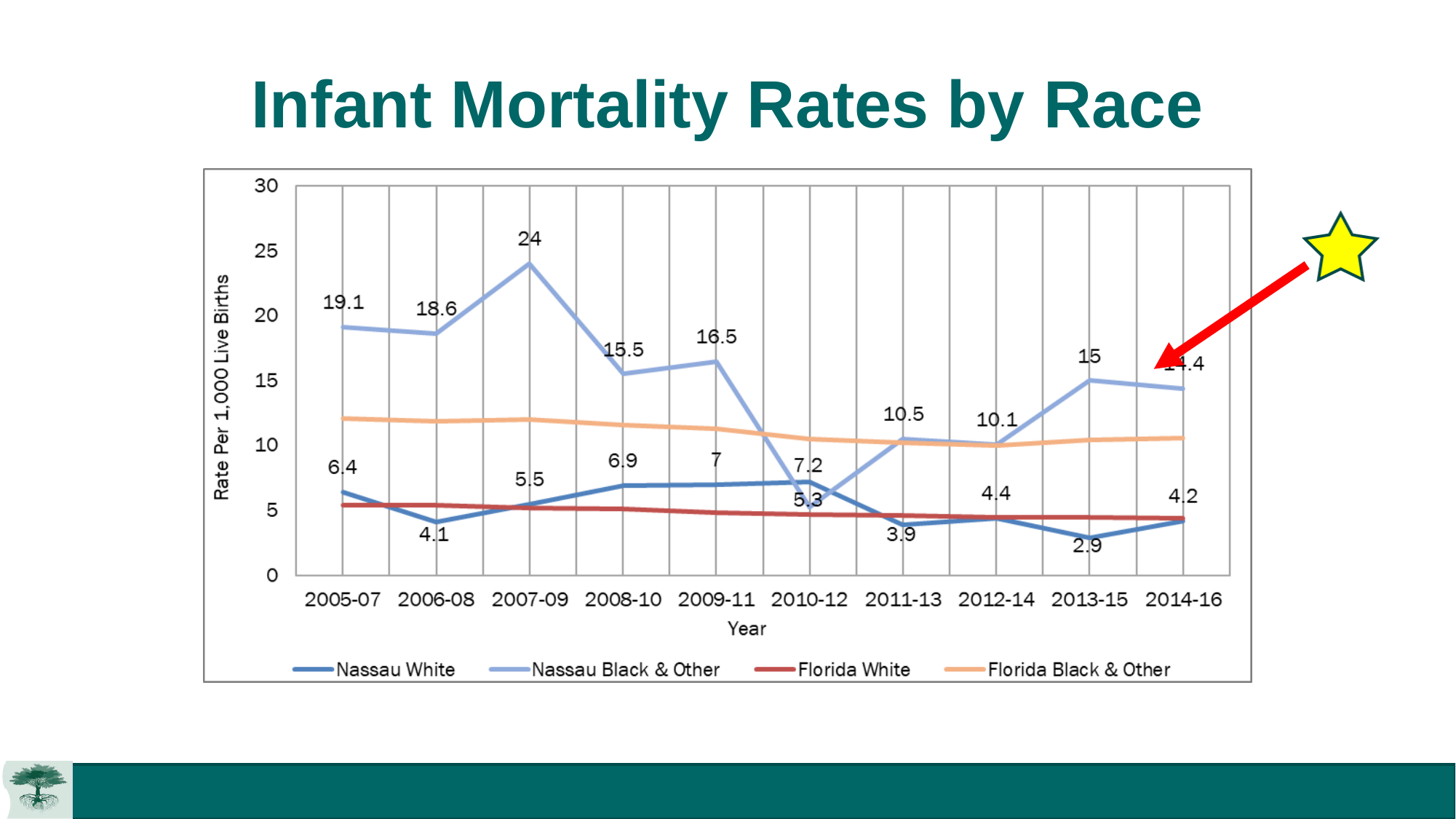
What kind of chart is shown on the slide? Line chart In 2008-10, which is higher: Nassau Black & Other or Nassau White? Nassau Black & Other In which year period is the Nassau Black & Other rate highest? 2007-09 What is the difference between the Nassau Black & Other rates for 2005-07 and 2006-08? 0.5 In which year period is the Nassau White rate lowest? 2013-15 How many series does the legend list? 4 What is the Nassau White rate for 2013-15? 2.9 What is the Nassau Black & Other rate for 2007-09? 24 What is the Nassau White rate for 2005-07? 6.4 Is the Florida Black & Other value for 2005-07 greater or less than 10? greater What is the label on the y axis? Rate Per 1,000 Live Births How many year periods are shown on the x axis? 10